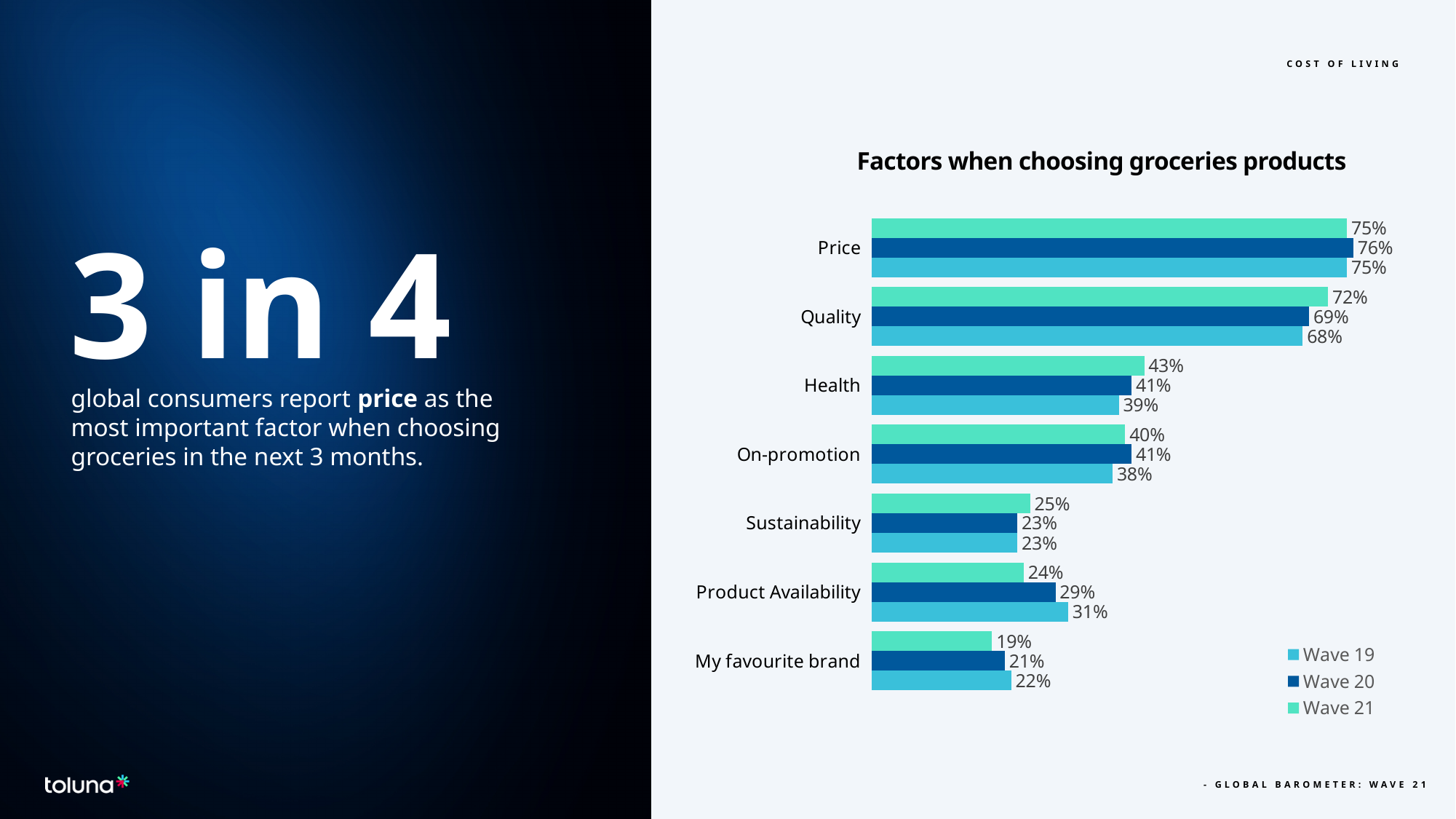
Which is larger for Product Availability: the Wave 19 value or the Wave 21 value? Wave 19 What is the Wave 19 value for Product Availability? 31% How many series does the legend list? 3 Which factor has the lowest Wave 21 value? My favourite brand How many factors (categories) are shown in the chart? 7 What is the difference between the Wave 20 and Wave 21 values for Health? 2% What is the difference between the Wave 21 and Wave 19 values for Quality? 4% Which factor has the highest Wave 20 value? Price What is the chart's title? Factors when choosing groceries products What is the Wave 20 value for Price? 76% What type of chart is shown on the slide? bar chart What is the Wave 21 value for Quality? 72%